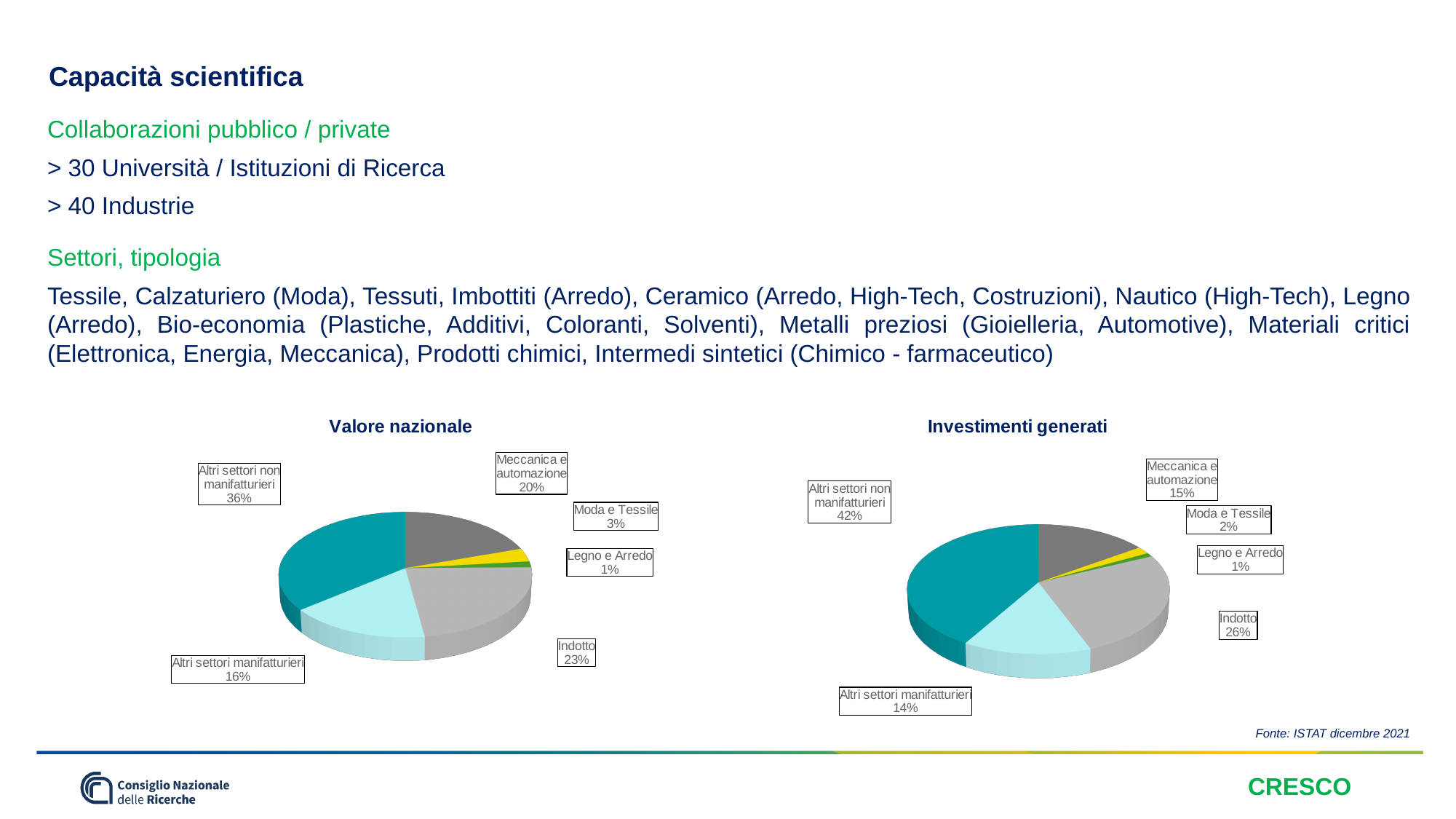
In the 'Valore nazionale' chart, which category has the largest share? Altri settori non manifatturieri In the 'Valore nazionale' chart, what is the difference between the shares of Indotto and Meccanica e automazione? 3% How many categories are shown in the 'Valore nazionale' chart? 6 In the 'Investimenti generati' chart, what share does Altri settori manifatturieri have? 14% What is the title of the chart on the left side of the slide? Valore nazionale In the 'Investimenti generati' chart, which category has the smallest share? Legno e Arredo What kind of chart is 'Investimenti generati'? Pie chart In the 'Valore nazionale' chart, what share does Indotto have? 23% In the 'Valore nazionale' chart, what share does Moda e Tessile have? 3% In the 'Valore nazionale' chart, which is larger: Meccanica e automazione or Altri settori manifatturieri? Meccanica e automazione In the 'Investimenti generati' chart, what share does Meccanica e automazione have? 15% In the 'Investimenti generati' chart, what is the difference between the shares of Altri settori non manifatturieri and Indotto? 16%